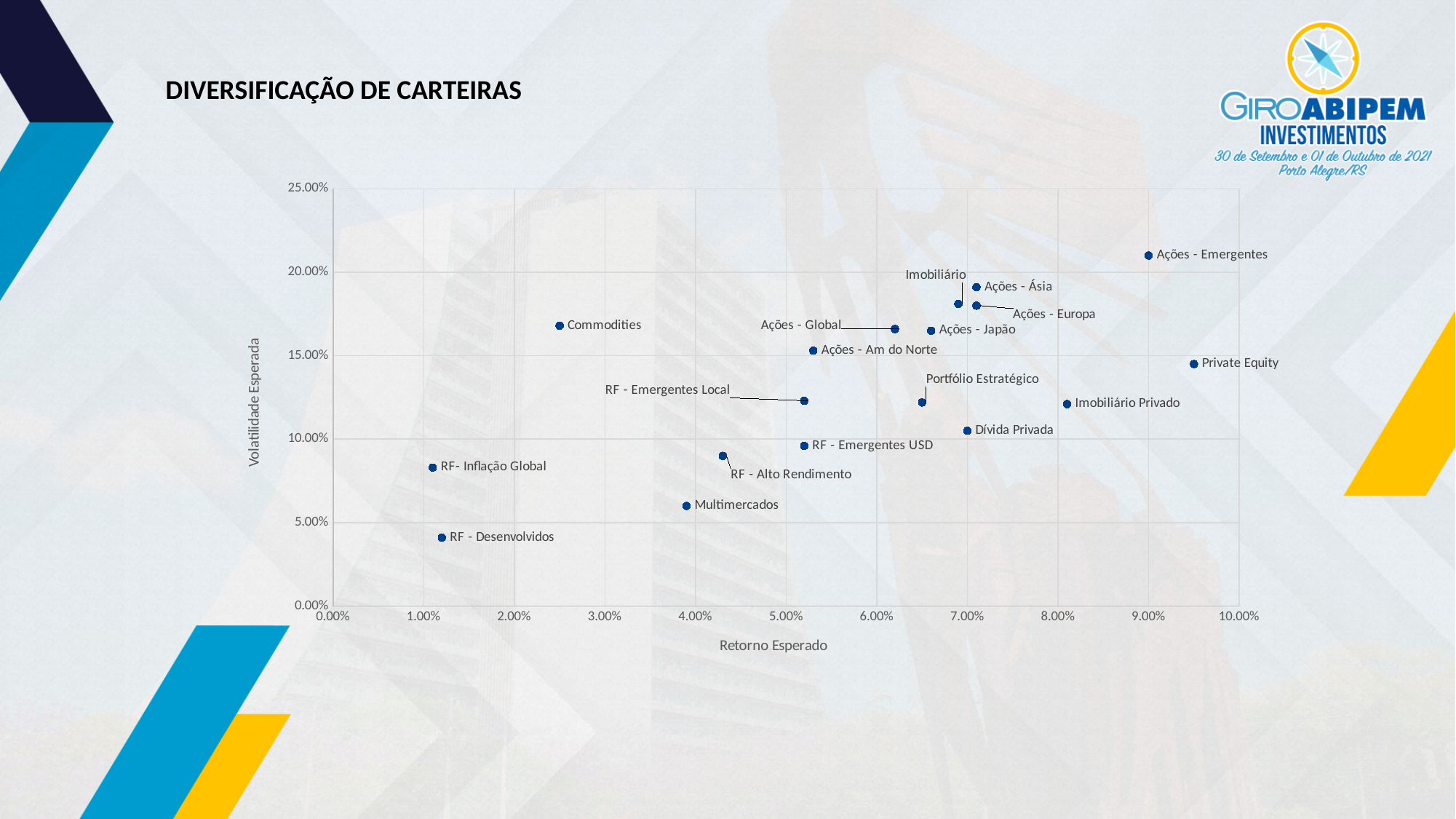
Which point has the highest expected return (Retorno Esperado)? Private Equity What kind of chart is shown on the slide? Scatter chart What is the title of the x axis? Retorno Esperado Which has the higher expected return, Commodities or Multimercados? Multimercados Which point has the lowest expected volatility (Volatilidade Esperada)? RF - Desenvolvidos Is the expected return for Private Equity greater or less than 9.00%? greater Is the expected volatility for Multimercados greater or less than 10.00%? less Is the expected volatility for Ações - Emergentes greater or less than 20.00%? greater Which has the higher expected volatility, Ações - Emergentes or Private Equity? Ações - Emergentes How many data points are plotted on the chart? 18 Which point has the highest expected volatility (Volatilidade Esperada)? Ações - Emergentes